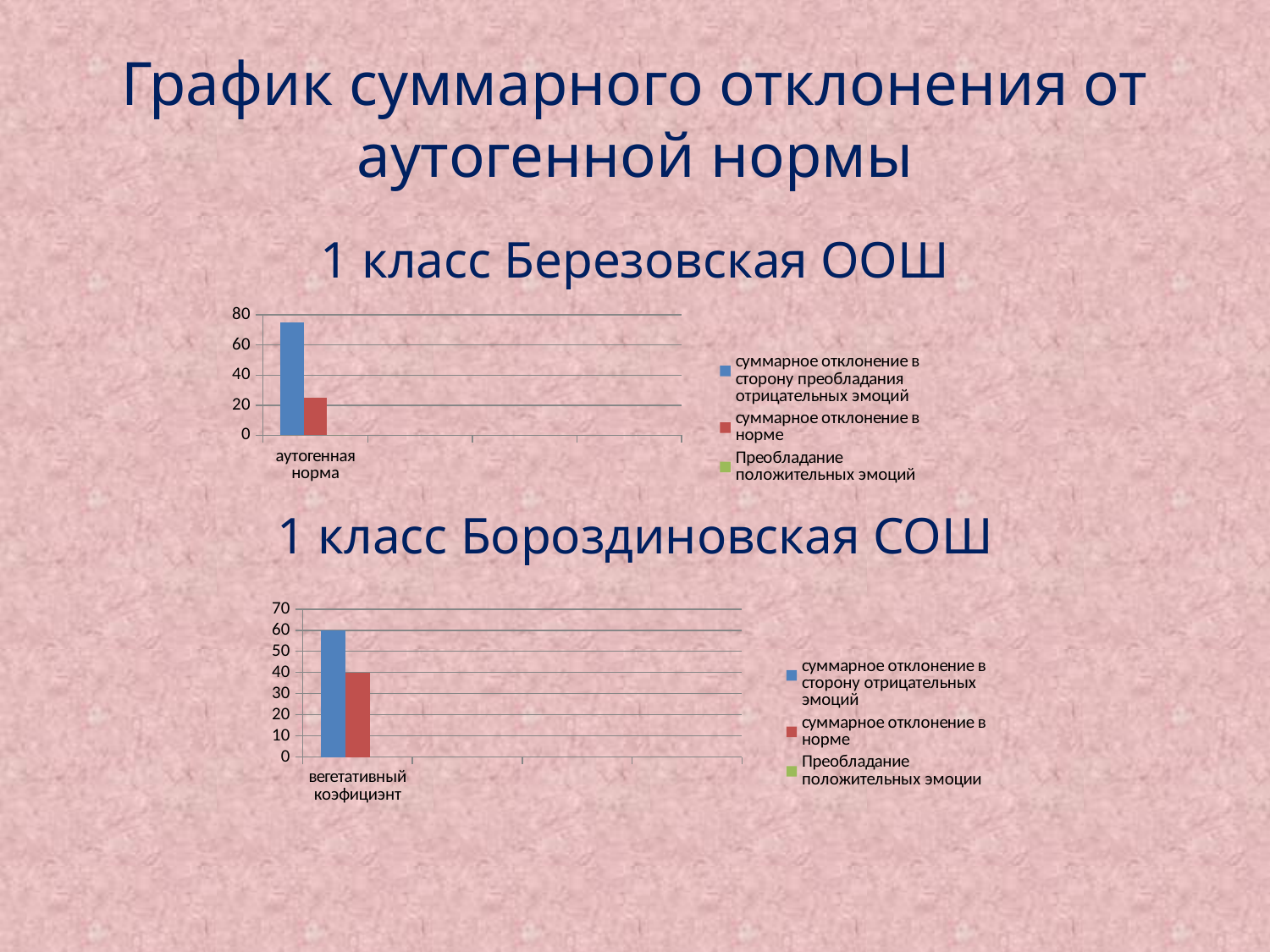
In the chart "1 класс Бороздиновская СОШ", what is the label of the category on the x axis? вегетативный коэфициэнт In the chart "1 класс Бороздиновская СОШ", what is the value for "суммарное отклонение в норме"? 40 In the chart "1 класс Бороздиновская СОШ", which series has the highest value? суммарное отклонение в сторону отрицательных эмоций In the chart "1 класс Березовская ООШ", what is the label of the category on the x axis? аутогенная норма In the chart "1 класс Бороздиновская СОШ", how many series does the legend list? 3 What kind of chart is shown under the heading "1 класс Березовская ООШ"? bar chart In the chart "1 класс Березовская ООШ", is the value for "суммарное отклонение в сторону преобладания отрицательных эмоций" greater or less than 60? greater In the chart "1 класс Березовская ООШ", is the value for "суммарное отклонение в норме" greater or less than 40? less In the chart "1 класс Бороздиновская СОШ", what is the difference between the values for "суммарное отклонение в сторону отрицательных эмоций" and "суммарное отклонение в норме"? 20 In the chart "1 класс Бороздиновская СОШ", what is the value for "суммарное отклонение в сторону отрицательных эмоций"? 60 In the chart "1 класс Березовская ООШ", how many series does the legend list? 3 In the chart "1 класс Березовская ООШ", which series has the taller bar: "суммарное отклонение в сторону преобладания отрицательных эмоций" or "суммарное отклонение в норме"? суммарное отклонение в сторону преобладания отрицательных эмоций